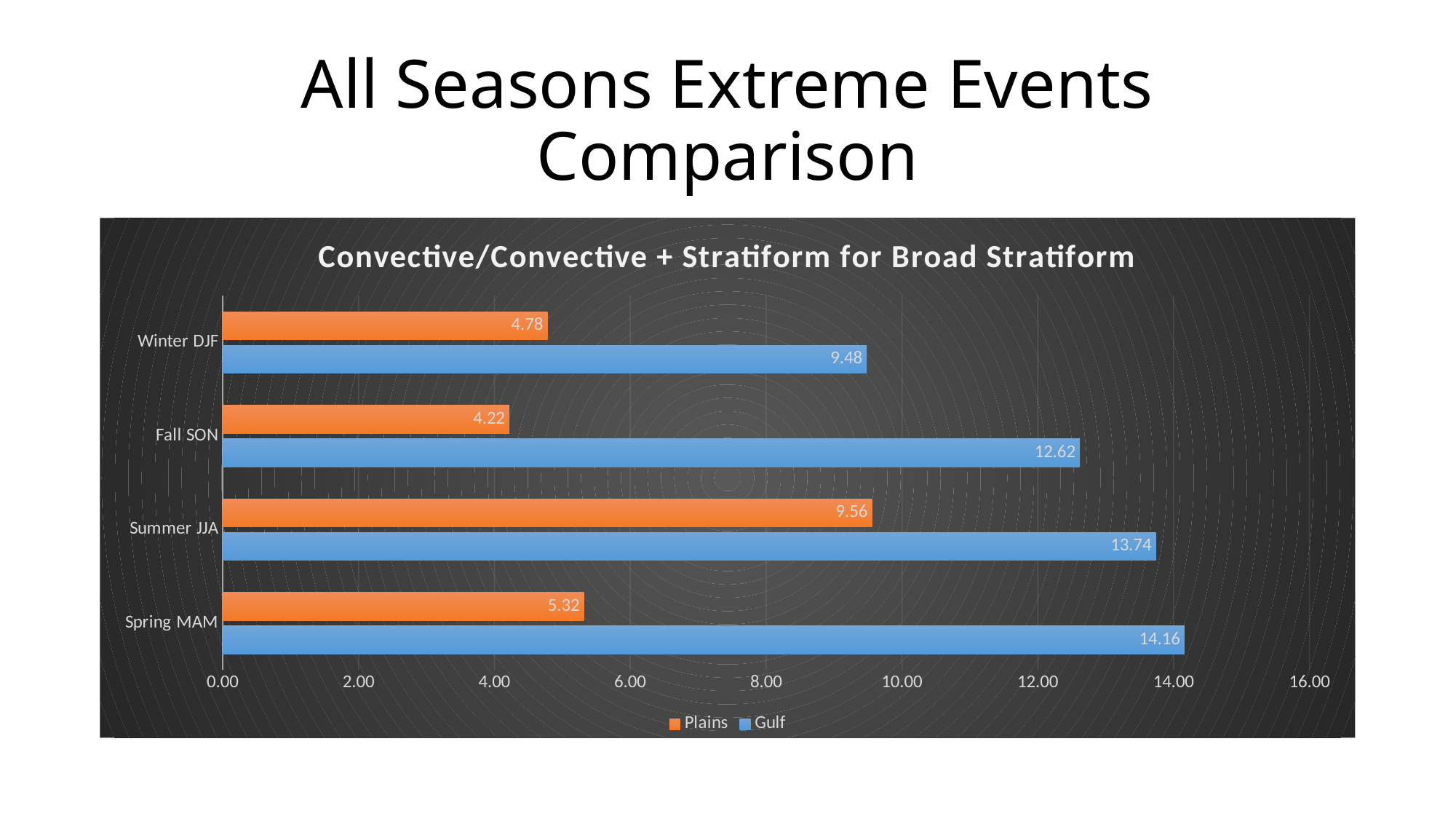
What is the Plains value for Summer JJA? 9.56 How many seasons are shown on the chart? 4 Which is larger for Winter DJF, the Plains value or the Gulf value? Gulf What kind of chart is shown on the slide? Bar chart What is the title of the chart? Convective/Convective + Stratiform for Broad Stratiform Which season has the lowest Plains value? Fall SON How many series does the legend list? 2 What is the Plains value for Fall SON? 4.22 What is the Gulf value for Winter DJF? 9.48 What is the Gulf value for Spring MAM? 14.16 Which season has the highest Gulf value? Spring MAM What is the difference between the Gulf and Plains values for Fall SON? 8.40